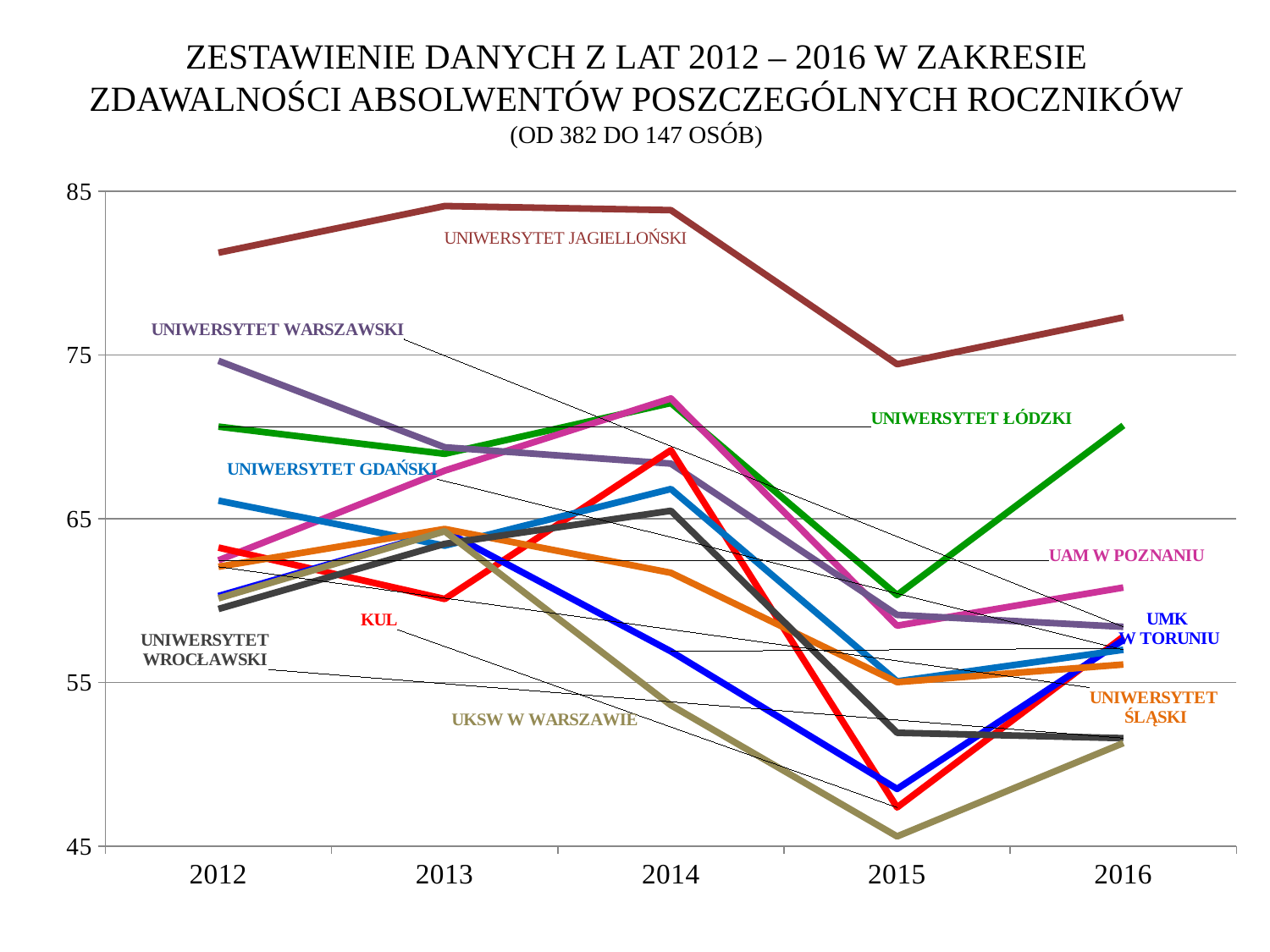
Is the value for UKSW w Warszawie in 2015 greater or less than 50? less Is the value for Uniwersytet Jagielloński in 2013 greater or less than 80? greater Is the value for Uniwersytet Łódzki in 2016 greater or less than 65? greater Which university has the highest line across all years on the chart? Uniwersytet Jagielloński Does the line for Uniwersytet Jagielloński rise or fall from 2014 to 2015? fall How many years are shown along the x axis of the chart? 5 In 2016, which is higher: Uniwersytet Łódzki or UAM w Poznaniu? Uniwersytet Łódzki Which university has the lowest value in 2015? UKSW w Warszawie What kind of chart is shown on the slide? line chart What range of years does the chart title say the data covers? 2012 – 2016 How many university series are labelled on the chart? 10